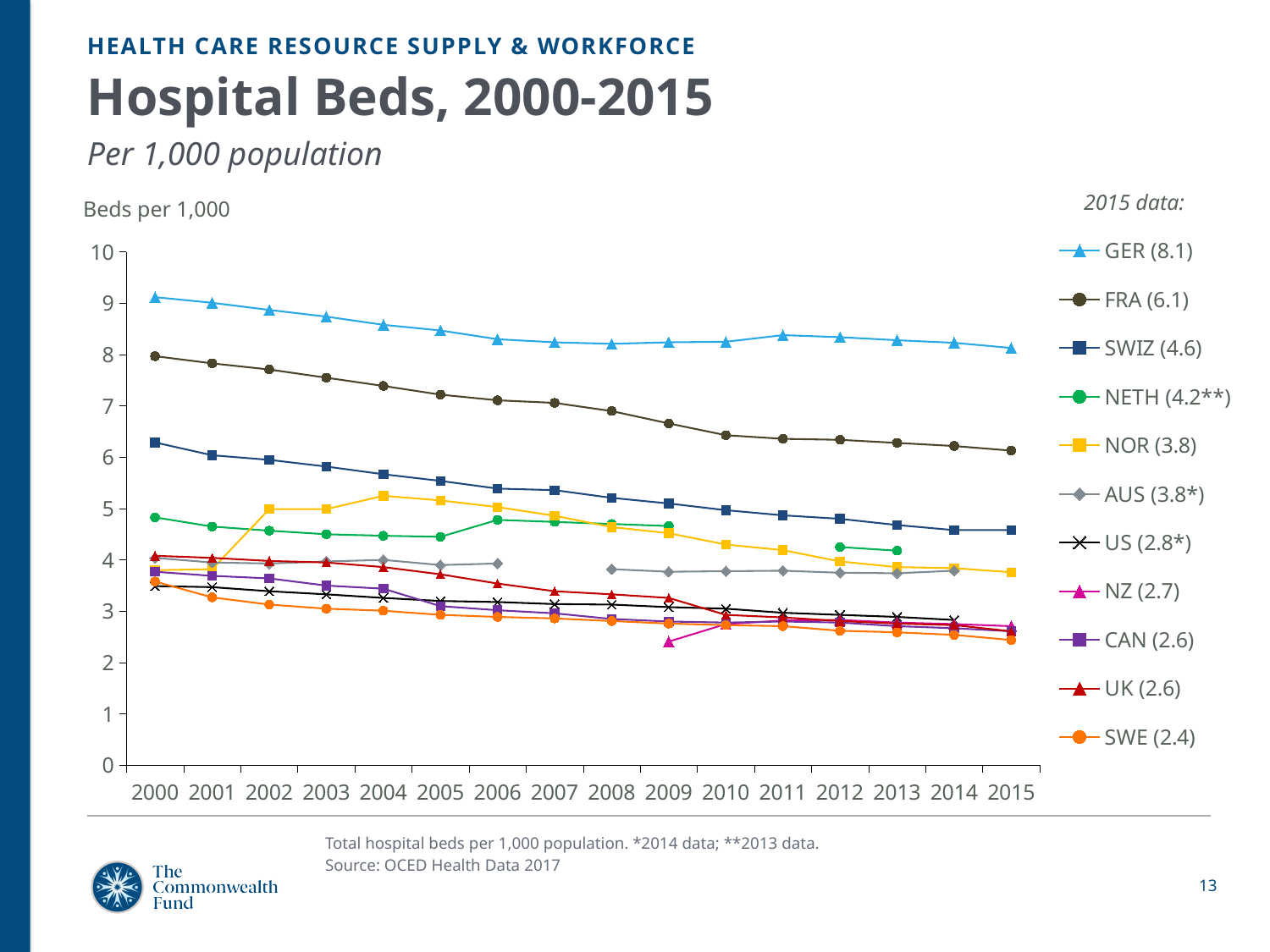
What is the difference between the 2015 values for GER and FRA? 2.0 What is the 2015 value for GER shown in the legend? 8.1 How many years are shown on the x axis? 16 Which country has the lowest number of hospital beds per 1,000 in 2015? SWE What kind of chart is shown on the slide? line chart Which country has the highest number of hospital beds per 1,000 in 2015? GER Does the GER line rise or fall from 2000 to 2015? falls What is the 2015 value for NZ shown in the legend? 2.7 Which has the larger 2015 value, SWIZ or NOR? SWIZ What is the 2015 value for FRA shown in the legend? 6.1 Is the value for FRA in 2000 greater or less than 7? greater How many series does the legend list? 11